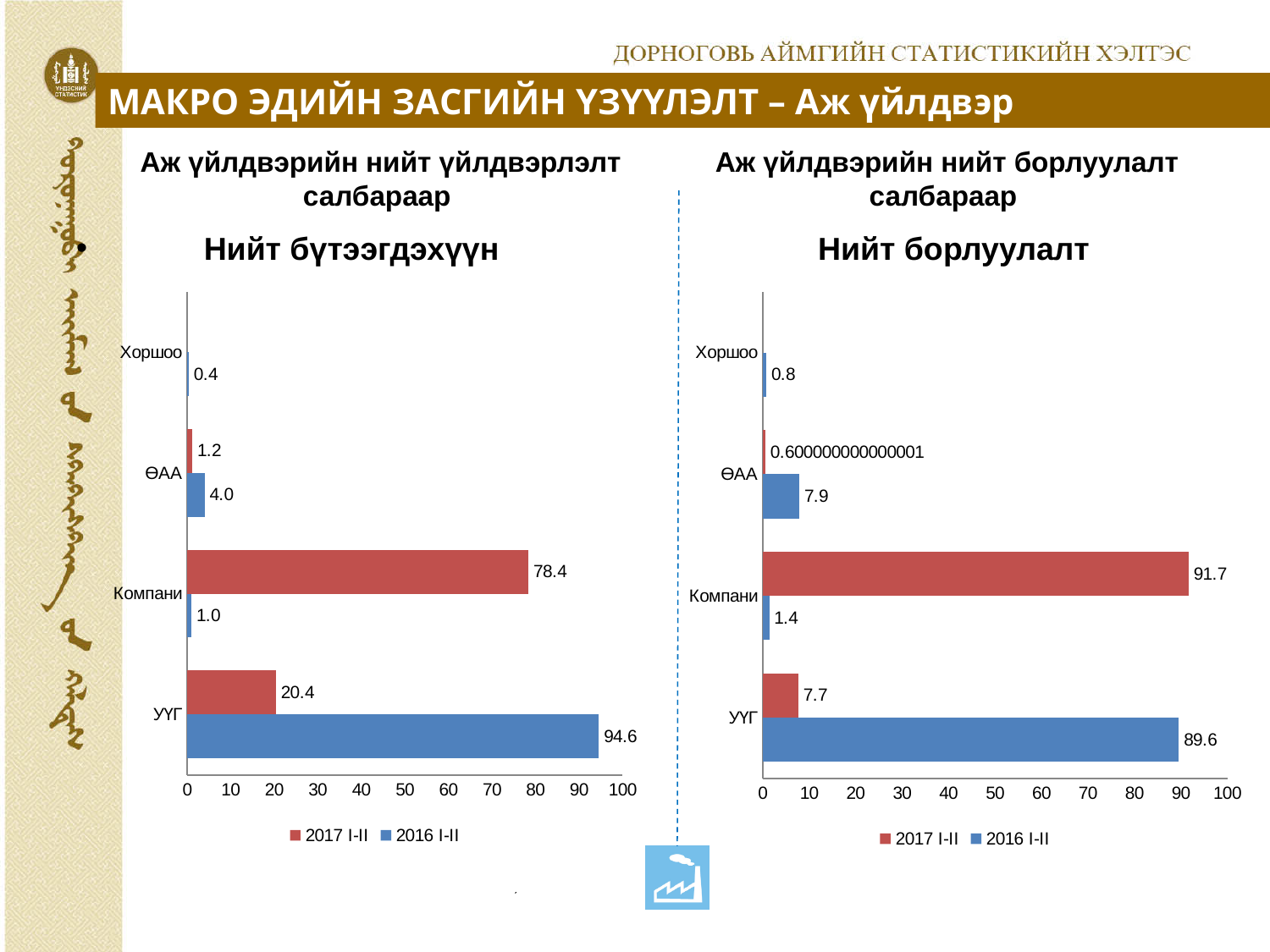
What kind of chart is the "Нийт борлуулалт" chart? Bar chart In the "Нийт борлуулалт" chart, what is the value for Хоршоо in the 2016 I-II series? 0.8 How many series does the legend of the "Нийт бүтээгдэхүүн" chart list? 2 In the "Нийт бүтээгдэхүүн" chart, what is the value for УҮГ in the 2016 I-II series? 94.6 In the "Нийт бүтээгдэхүүн" chart, what is the difference between the 2016 I-II and 2017 I-II values for УҮГ? 74.2 In the "Нийт бүтээгдэхүүн" chart, what is the value for ӨАА in the 2016 I-II series? 4.0 In the "Нийт борлуулалт" chart, which category has the lowest value in the 2016 I-II series? Хоршоо In the "Нийт бүтээгдэхүүн" chart, which category has the highest value in the 2017 I-II series? Компани In the "Нийт борлуулалт" chart, what is the value for УҮГ in the 2016 I-II series? 89.6 In the "Нийт бүтээгдэхүүн" chart, what is the value for Компани in the 2017 I-II series? 78.4 In the "Нийт борлуулалт" chart, what is the value for Компани in the 2017 I-II series? 91.7 In the "Нийт борлуулалт" chart, which is larger for ӨАА: the 2016 I-II value or the 2017 I-II value? 2016 I-II